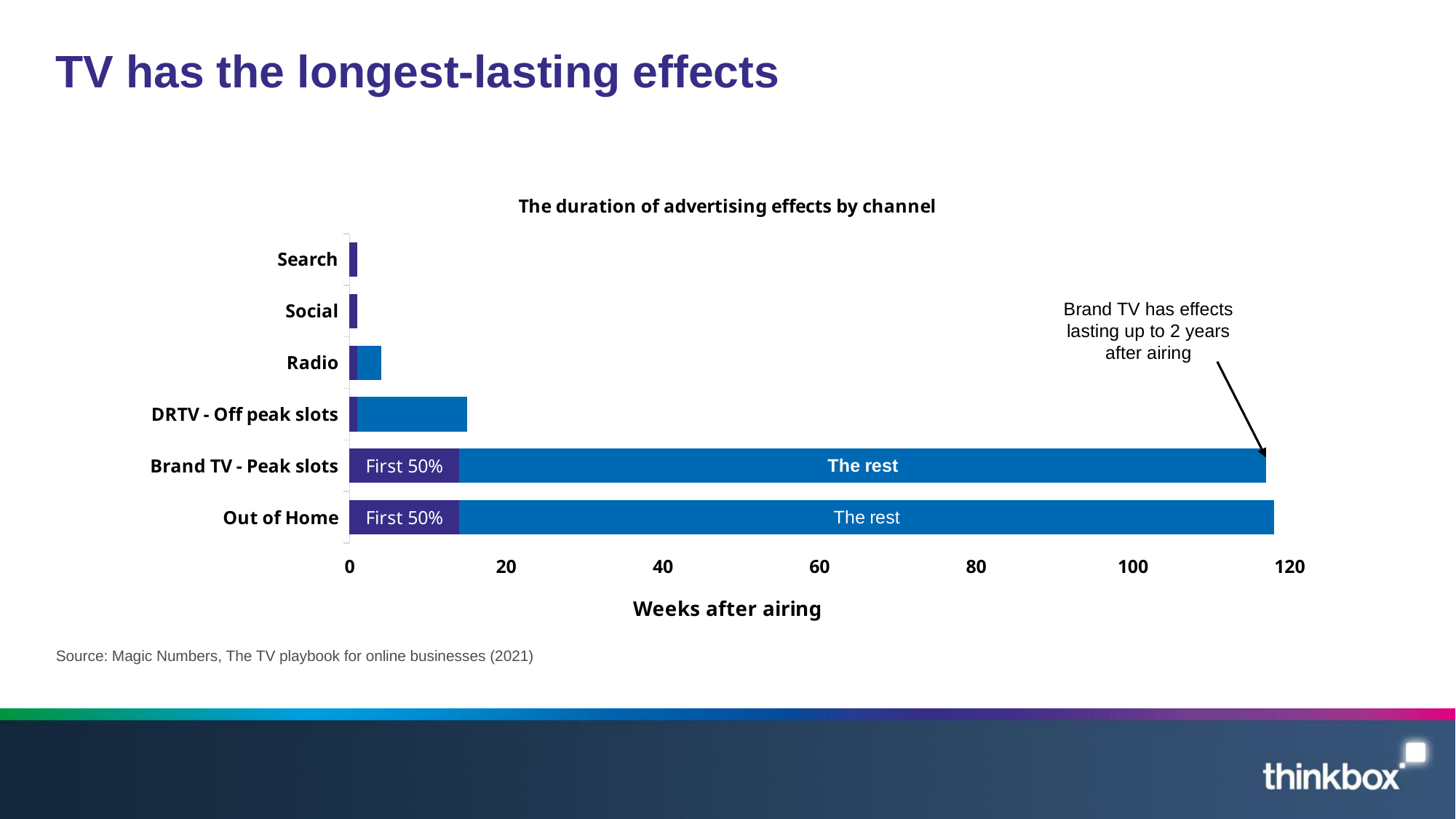
Is the value for Out of Home greater or less than 100 weeks? greater How many channels (categories) are plotted in the chart? 6 What is the title of the chart? The duration of advertising effects by channel Which has a longer duration of advertising effect, DRTV - Off peak slots or Radio? DRTV - Off peak slots Is the value for Search greater or less than 20 weeks? less Is the value for Brand TV - Peak slots greater or less than 100 weeks? greater What type of chart is shown on the slide? Bar chart Which has a longer duration of advertising effect, Radio or Social? Radio Which has a longer duration of advertising effect, Brand TV - Peak slots or DRTV - Off peak slots? Brand TV - Peak slots What is the label of the horizontal axis? Weeks after airing